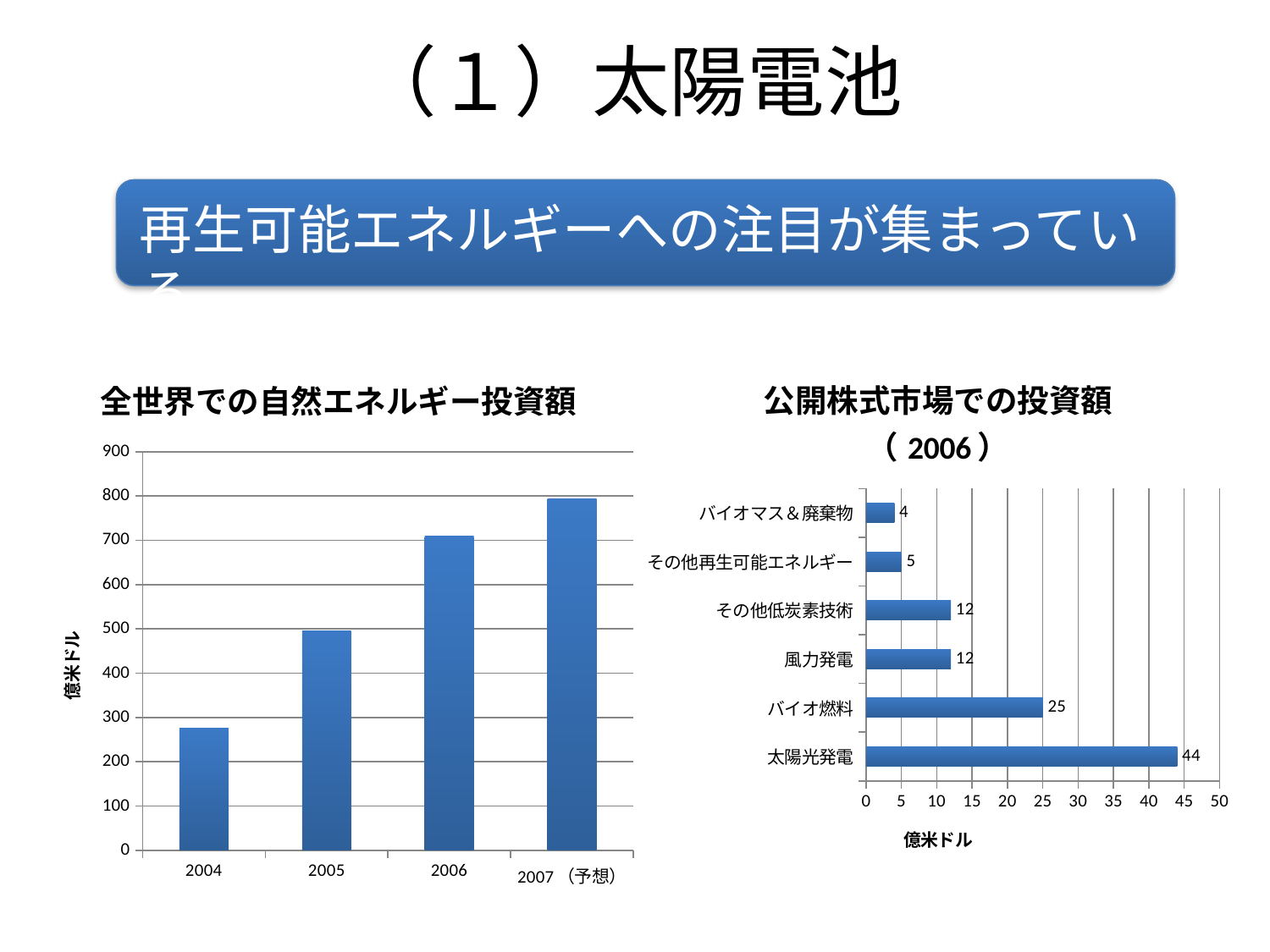
In the chart titled 公開株式市場での投資額（2006）, what is the value for 太陽光発電? 44 In the chart titled 全世界での自然エネルギー投資額, do the values rise or fall from 2004 to 2007? rise In the chart titled 公開株式市場での投資額（2006）, what is the difference between the values for 太陽光発電 and バイオ燃料? 19 What kind of chart is the chart titled 全世界での自然エネルギー投資額? bar chart In the chart titled 全世界での自然エネルギー投資額, is the value for 2005 greater or less than 400? greater In the chart titled 公開株式市場での投資額（2006）, what is the value for バイオ燃料? 25 In the chart titled 公開株式市場での投資額（2006）, how many categories are shown? 6 In the chart titled 公開株式市場での投資額（2006）, which is larger, the value for その他再生可能エネルギー or the value for 風力発電? 風力発電 In the chart titled 公開株式市場での投資額（2006）, what is the value for バイオマス＆廃棄物? 4 In the chart titled 公開株式市場での投資額（2006）, which category has the highest value? 太陽光発電 In the chart titled 全世界での自然エネルギー投資額, is the value for 2004 greater or less than 300? less In the chart titled 公開株式市場での投資額（2006）, which category has the lowest value? バイオマス＆廃棄物